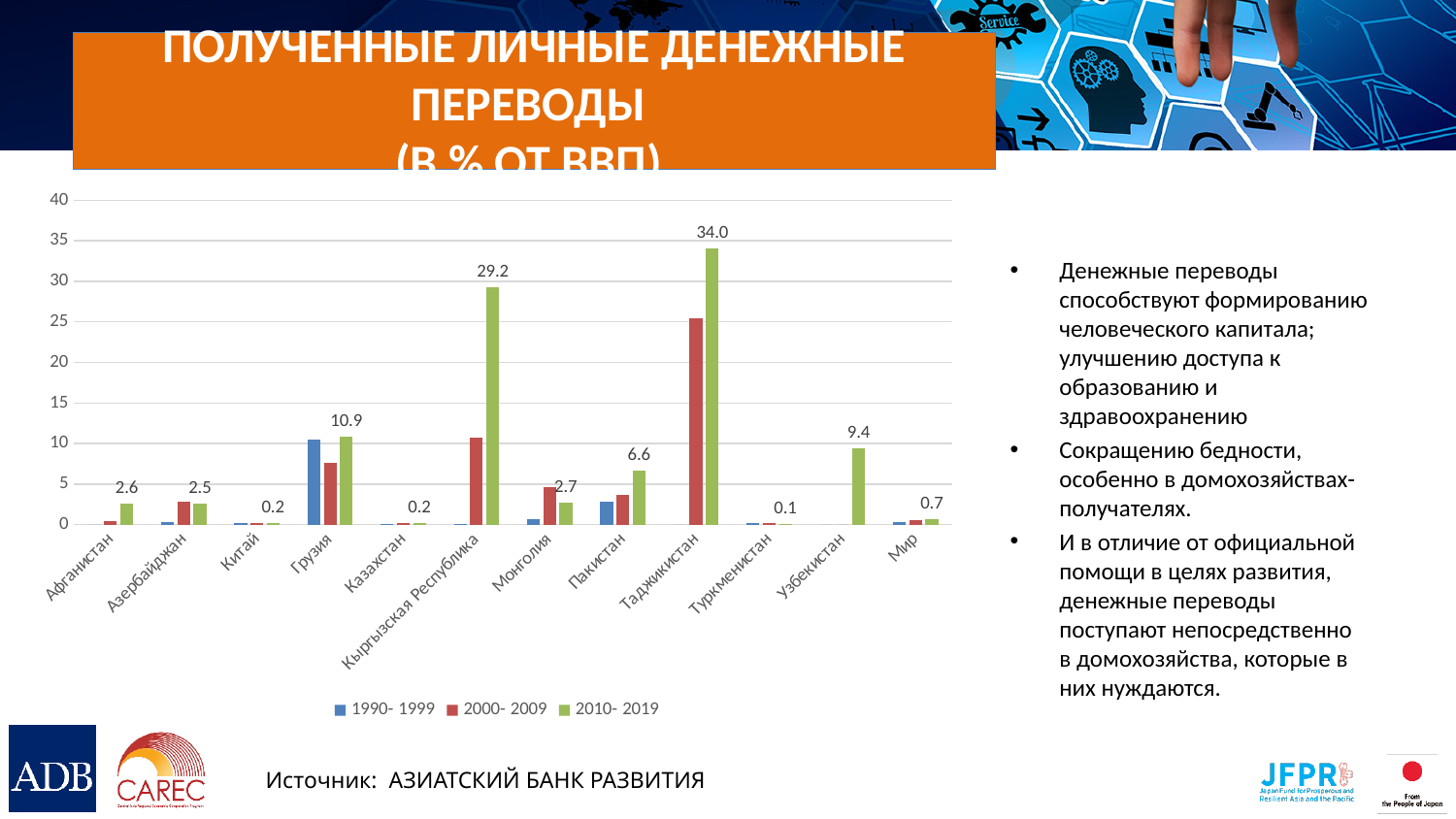
Is the 2000-2009 value for Таджикистан greater or less than 20? greater What is the value for Кыргызская Республика in the 2010-2019 series? 29.2 What kind of chart is shown on the slide? Bar chart What is the value for Таджикистан in the 2010-2019 series? 34.0 Which category has the highest value in the 2010-2019 series? Таджикистан Which category has the lowest labelled value in the 2010-2019 series? Туркменистан How many series does the legend list? 3 How many categories are shown on the x axis? 12 What is the difference between the 2010-2019 values for Таджикистан and Кыргызская Республика? 4.8 What is the value for Грузия in the 2010-2019 series? 10.9 What is the value for Узбекистан in the 2010-2019 series? 9.4 In the 2010-2019 series, which is larger: Пакистан or Монголия? Пакистан